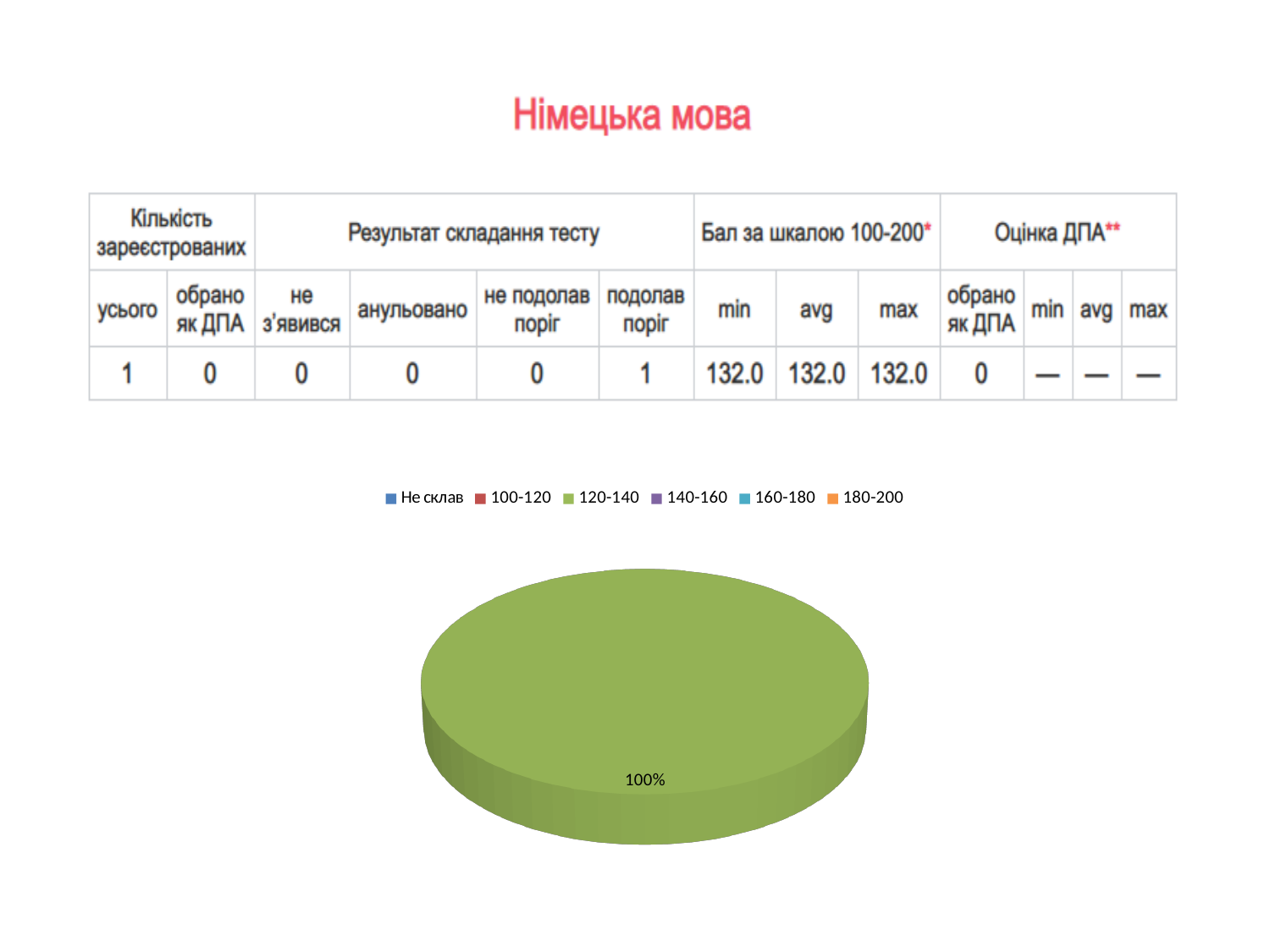
How many entries does the legend of the pie chart list? 6 What colour is the 120-140 category in the pie chart legend? green What percentage label is printed on the pie chart? 100% What is the first entry listed in the pie chart legend? Не склав What share of the pie chart does the 120-140 category take? 100% How many slices are visible in the pie chart? 1 Which category makes up the entire pie chart? 120-140 What kind of chart is shown on the slide? pie chart